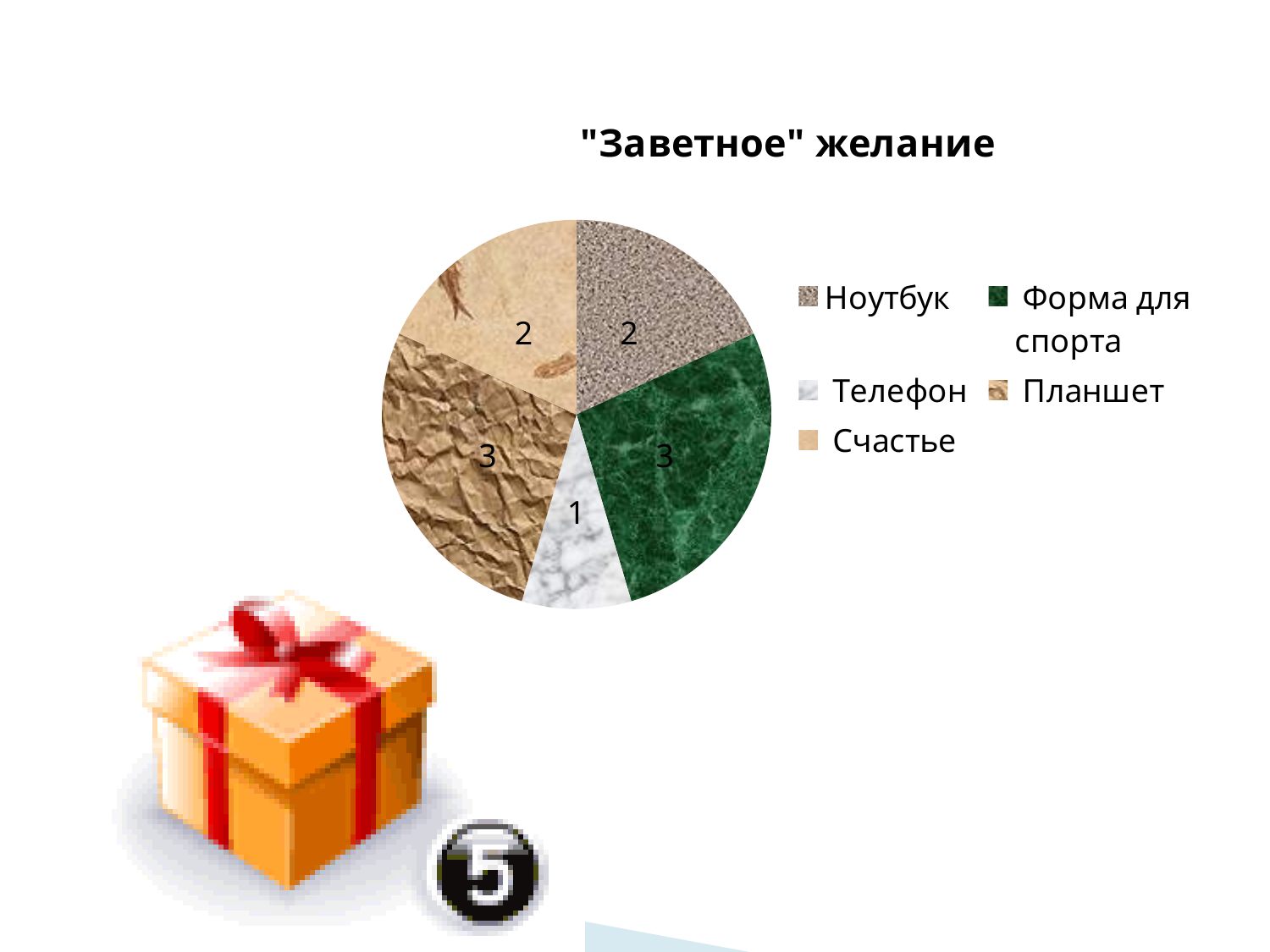
What is the value for Планшет in the pie chart? 3 What type of chart is shown on the slide? pie chart What is the value for Телефон in the pie chart? 1 How many categories does the legend of the pie chart list? 5 What is the difference between the values for Форма для спорта and Телефон? 2 Which category has the smallest slice in the pie chart? Телефон What is the total of all slice values in the pie chart? 11 What is the value for Форма для спорта in the pie chart? 3 What is the value for Счастье in the pie chart? 2 What is the value for Ноутбук in the pie chart? 2 Which is larger in the pie chart, Планшет or Телефон? Планшет What is the title of the chart? "Заветное" желание